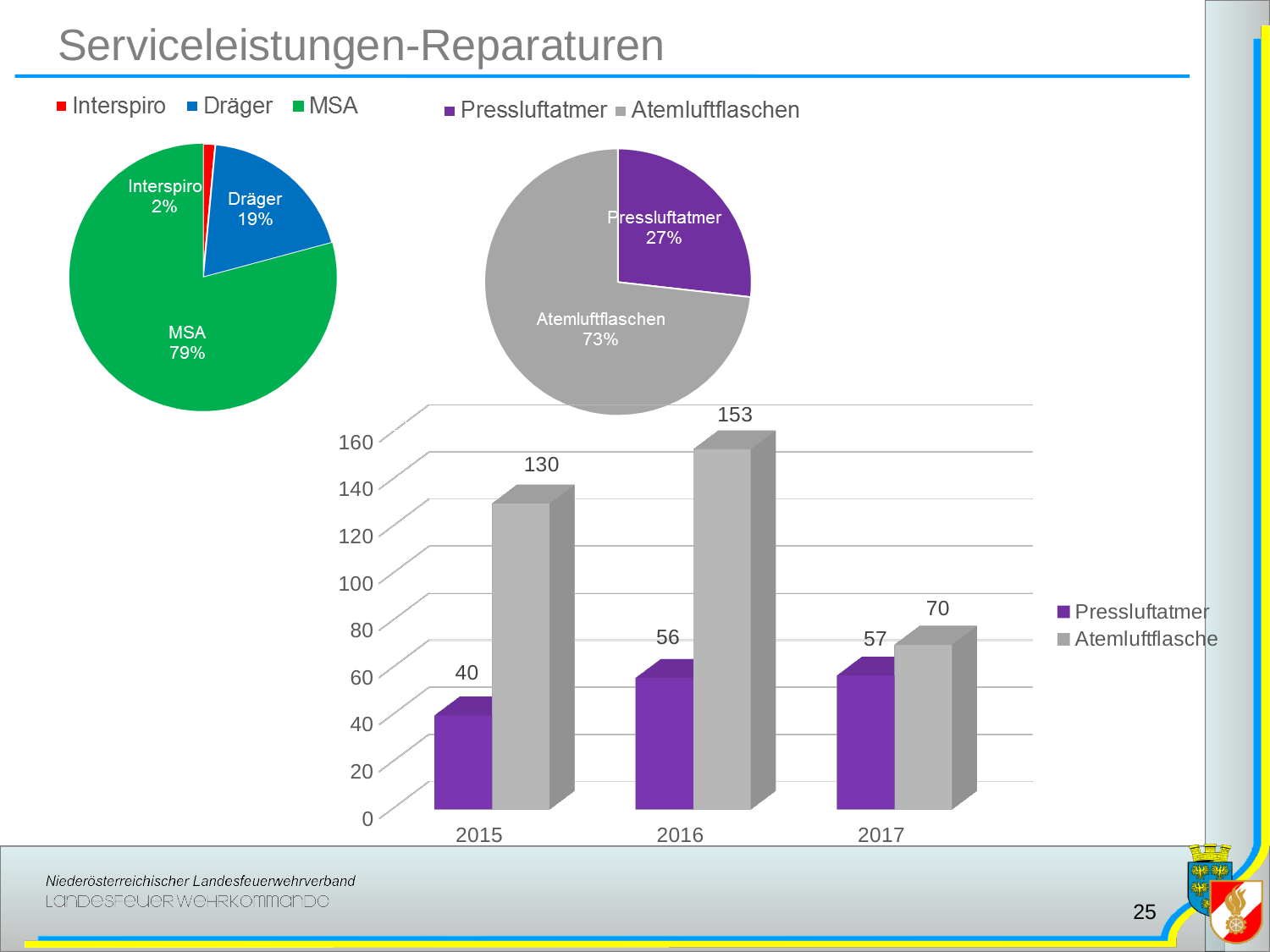
In the bar chart at the bottom, what is the value for Pressluftatmer in 2015? 40 In the pie chart on the left, how many categories are shown? 3 In the pie chart on the left, what share does Dräger have? 19% In the bar chart at the bottom, what is the value for Atemluftflasche in 2016? 153 What kind of chart is the chart at the bottom of the slide? Bar chart In the bar chart at the bottom, in which year is the Atemluftflasche value highest? 2016 In the bar chart at the bottom, what is the difference between Atemluftflasche and Pressluftatmer in 2017? 13 In the pie chart on the right, what is the difference between the Atemluftflaschen share and the Pressluftatmer share? 46% In the pie chart on the left, what share does MSA have? 79% In the pie chart on the right, what share does Atemluftflaschen have? 73% In the bar chart at the bottom, how many series does the legend list? 2 In the pie chart on the left, which category has the smallest slice? Interspiro